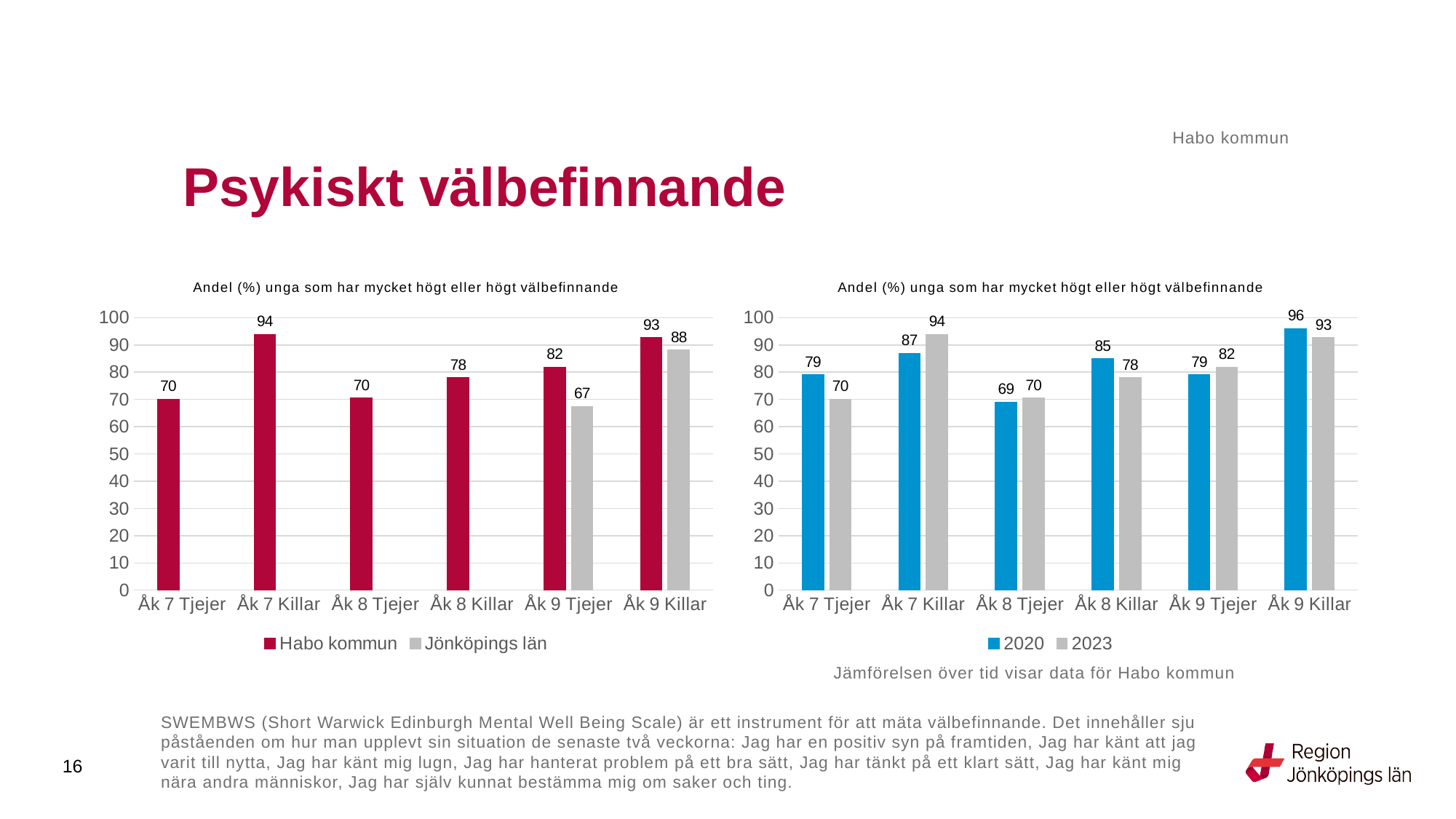
In the left chart, which category has the highest Habo kommun value? Åk 7 Killar How many categories are shown on the x axis of the right chart? 6 In the right chart, which category has the lowest 2020 value? Åk 8 Tjejer In the left chart, what is the Jönköpings län value for Åk 9 Tjejer? 67 In the left chart, how many series does the legend list? 2 In the left chart, what is the difference between the Habo kommun and Jönköpings län values for Åk 9 Killar? 5 In the right chart, what is the difference between the 2020 and 2023 values for Åk 7 Tjejer? 9 In the right chart, what is the 2023 value for Åk 9 Tjejer? 82 In the right chart, what is the 2020 value for Åk 8 Killar? 85 In the right chart, which is larger for Åk 7 Killar, the 2020 value or the 2023 value? 2023 In the left chart, what is the Habo kommun value for Åk 7 Killar? 94 What type of chart is the left chart? Bar chart